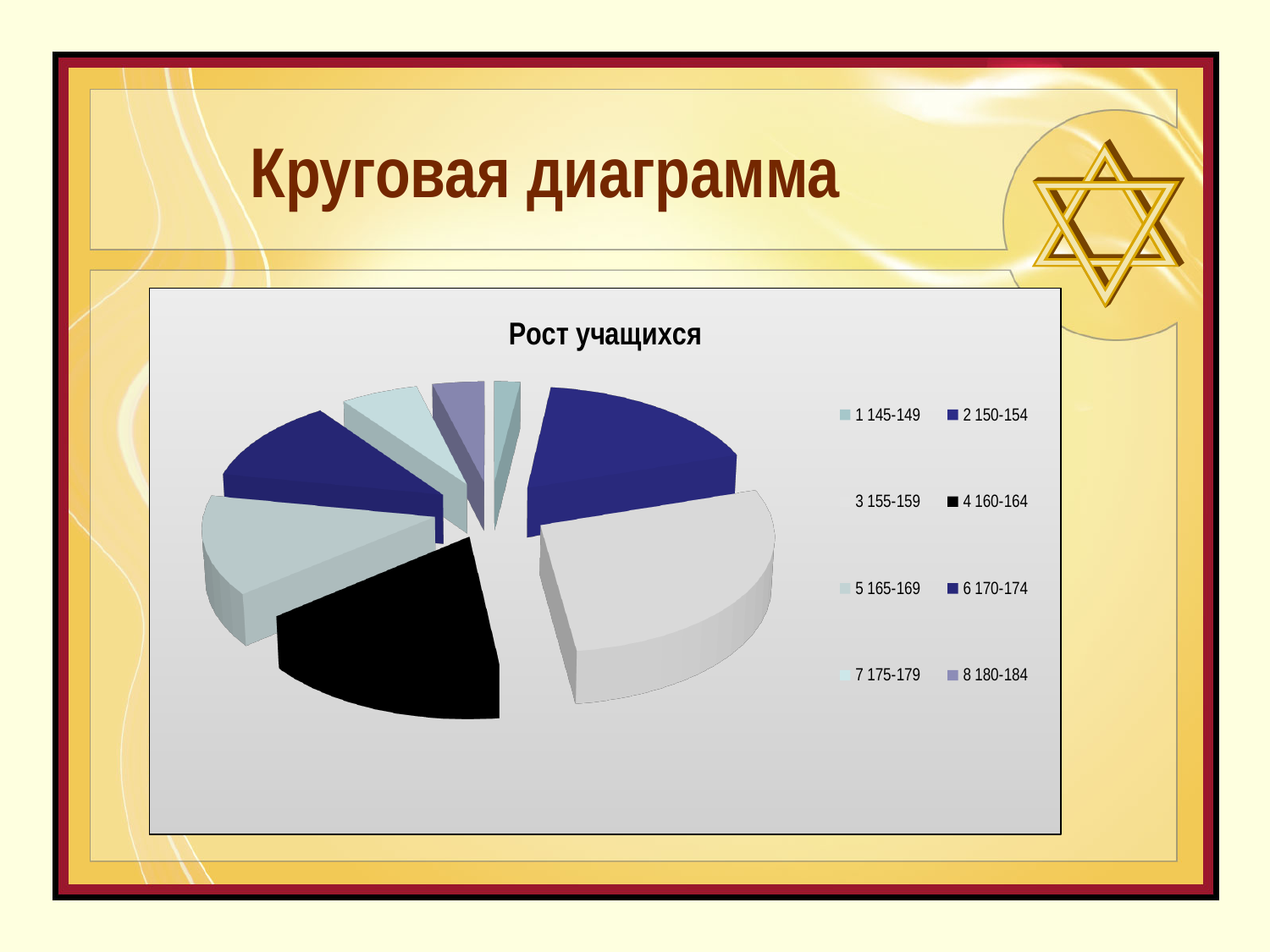
Which category has the smallest slice of the pie? 1 145-149 What kind of chart is shown on the slide? pie chart Which slice is larger: 4 160-164 or 7 175-179? 4 160-164 How many categories (slices) does the pie chart have? 8 What is the title of the chart? Рост учащихся Which slice is larger: 3 155-159 or 4 160-164? 3 155-159 What is the last category listed in the legend? 8 180-184 Which category has the largest slice of the pie? 3 155-159 Which slice is larger: 5 165-169 or 1 145-149? 5 165-169 Which category is shown in black in the pie chart? 4 160-164